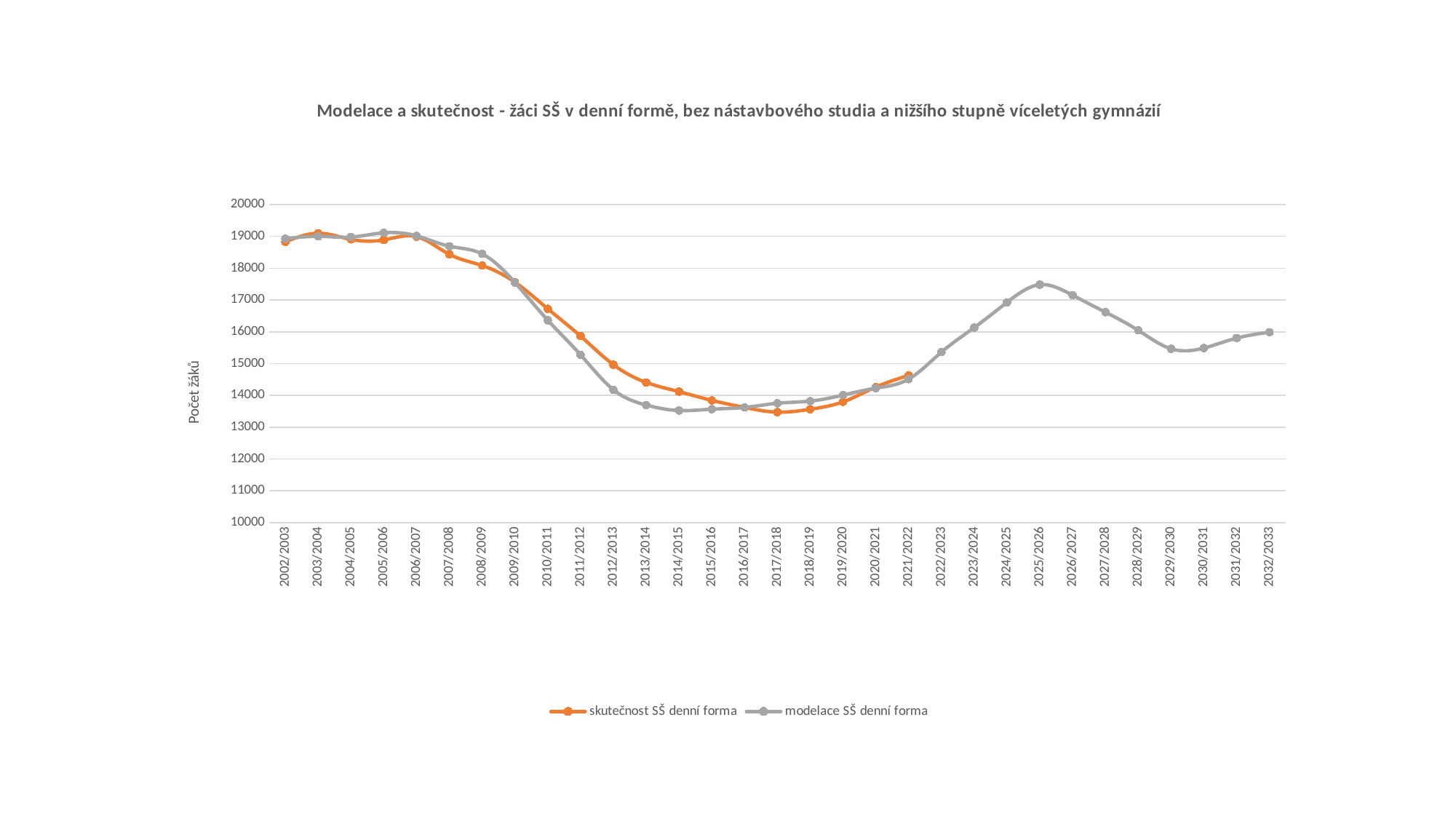
How many school years are shown on the x axis? 31 Does the 'modelace SŠ denní forma' series rise or fall from 2009/2010 to 2014/2015? fall What kind of chart is shown on the slide? line chart Is the value of 'modelace SŠ denní forma' for 2029/2030 greater or less than 16000? less Among the school years from 2022/2023 to 2032/2033, which has the highest value of 'modelace SŠ denní forma'? 2025/2026 Is the value of 'skutečnost SŠ denní forma' for 2017/2018 greater or less than 14000? less Does the 'skutečnost SŠ denní forma' series rise or fall from 2017/2018 to 2021/2022? rise What is the label of the y axis? Počet žáků How many series does the legend list? 2 Is the value of 'modelace SŠ denní forma' for 2014/2015 greater or less than 14000? less Which series has the larger value for 2012/2013, 'skutečnost SŠ denní forma' or 'modelace SŠ denní forma'? skutečnost SŠ denní forma